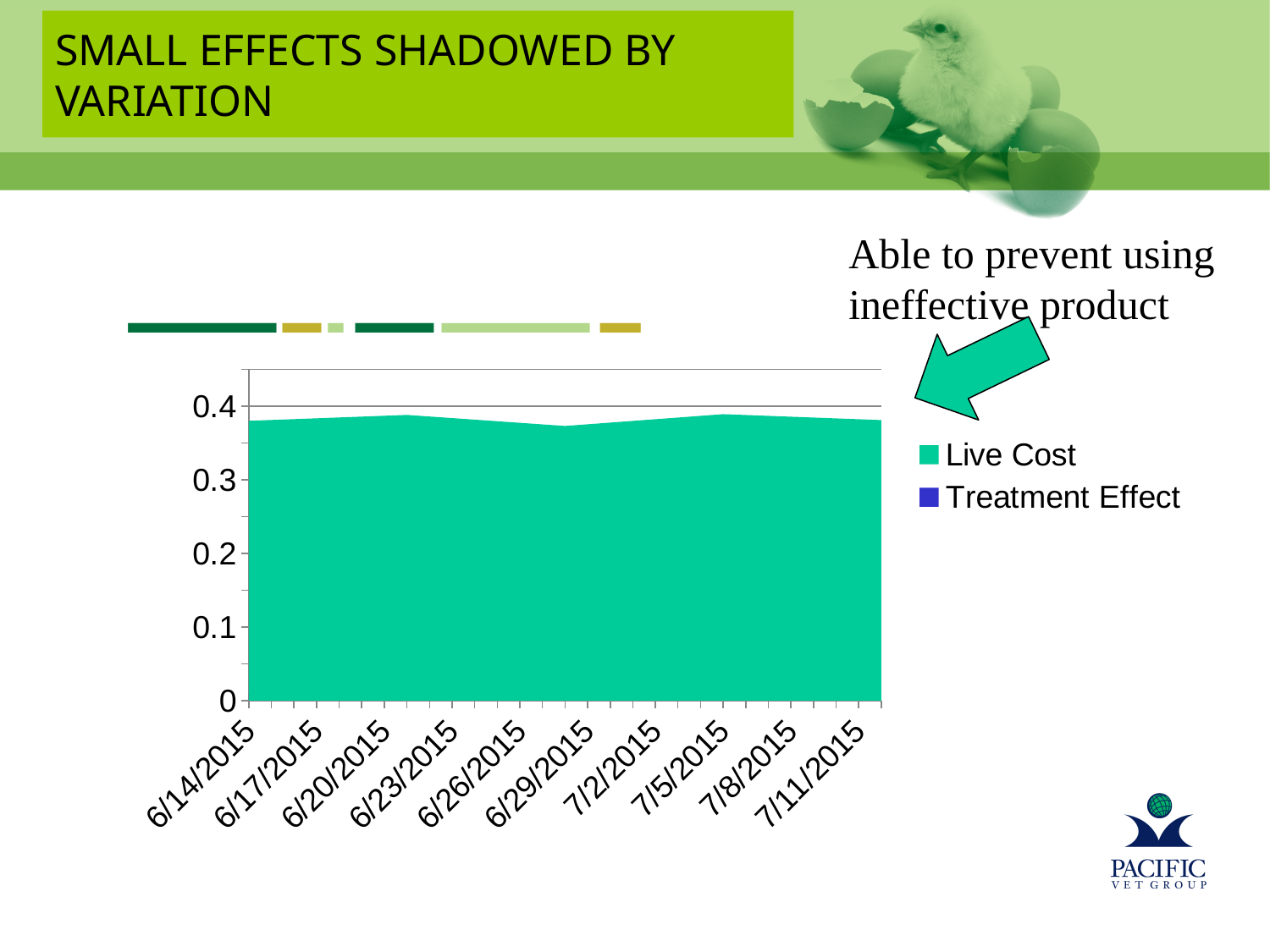
Is the Live Cost value for 6/14/2015 greater or less than 0.3? greater Is the Live Cost value for 6/14/2015 greater or less than 0.4? less How many series does the chart legend list? 2 Does the Live Cost series ever exceed 0.4 across the dates shown? No How many date labels are shown on the x axis of the chart? 10 What is the first date label on the x axis of the chart? 6/14/2015 What is the highest value shown on the y axis of the chart? 0.4 What kind of chart is shown on the slide? area chart What are the two series named in the chart legend? Live Cost and Treatment Effect